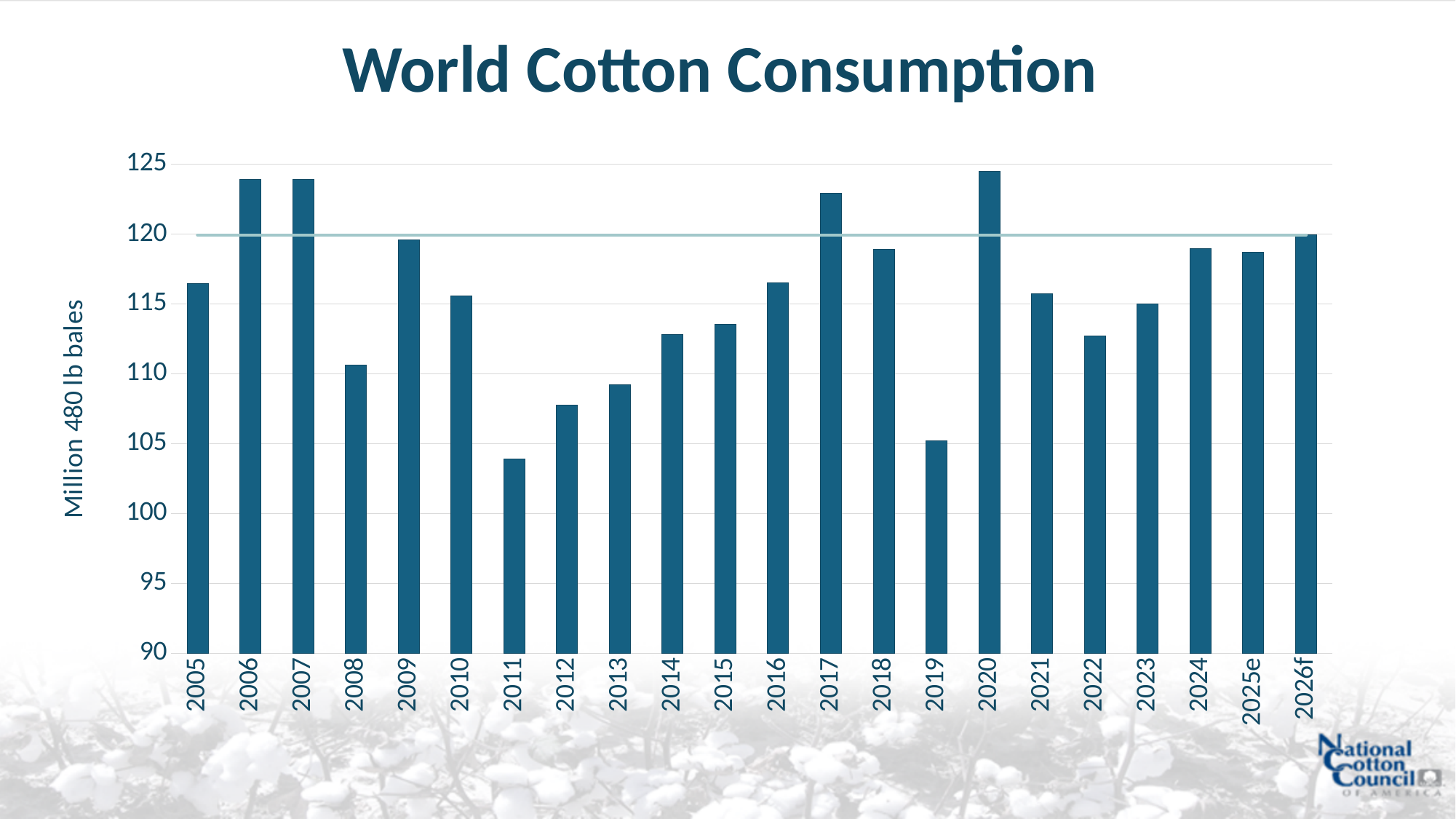
Is the value for 2017 greater or less than 120? greater Which is larger, the value for 2008 or the value for 2011? 2008 Which is larger, the value for 2017 or the value for 2018? 2017 Is the value for 2014 greater or less than 115? less What is the label on the vertical axis? Million 480 lb bales Do the values rise or fall from 2011 to 2017? rise Is the value for 2011 greater or less than 105? less Which year has the lowest world cotton consumption? 2011 What kind of chart is shown on the slide? bar chart How many years (bars) are plotted on the chart? 22